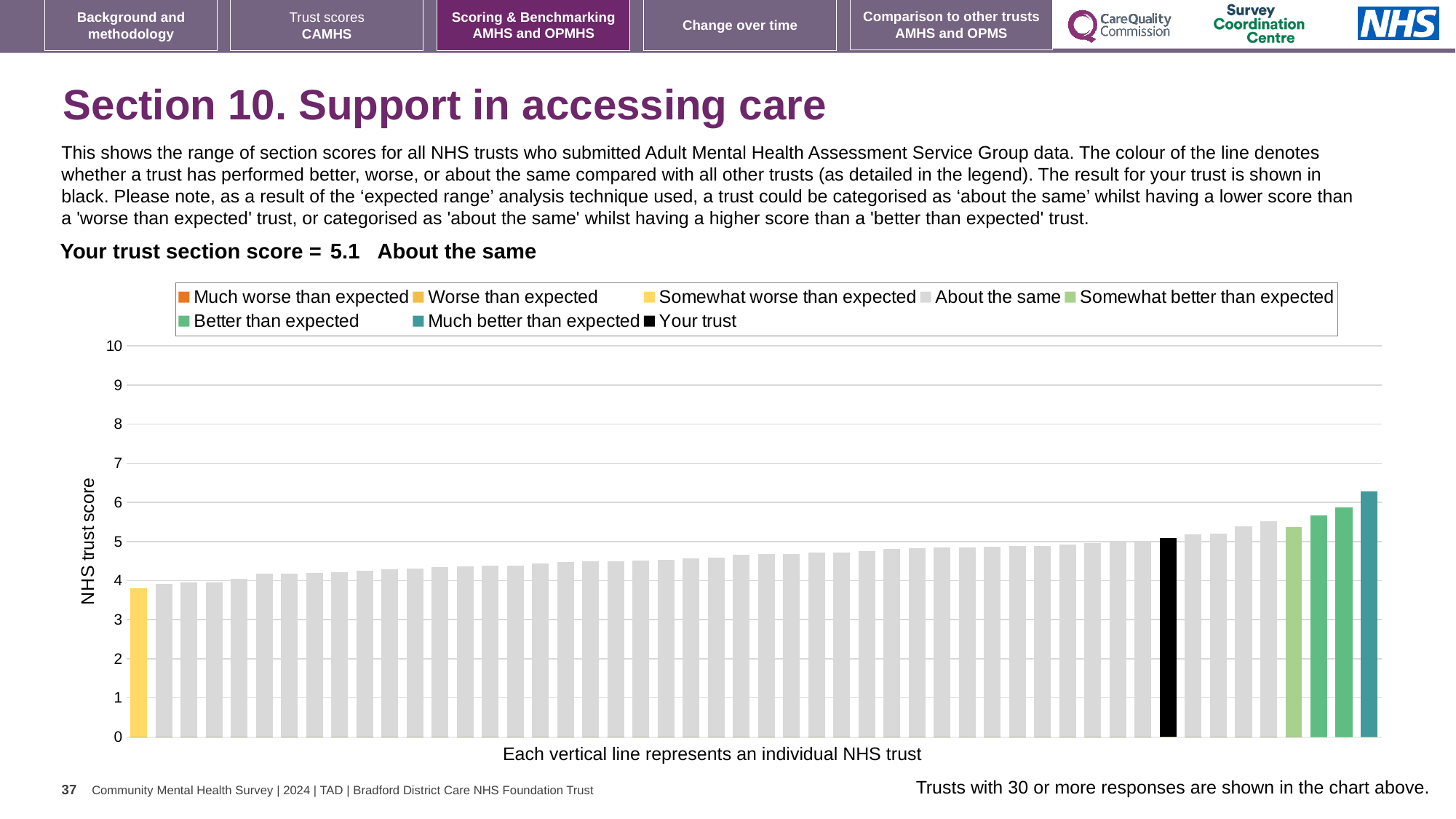
Do the bar values rise or fall from left to right along the x axis? rise Is the value of the lowest bar greater or less than 4? less What colour is the bar representing your trust? black What kind of chart is shown on the slide? bar chart Which legend category does the highest bar belong to? Much better than expected Is the value of the highest bar greater or less than 7? less Is the value for your trust greater or less than 5? greater Which is larger, the leftmost bar or the rightmost bar? the rightmost bar What is the label on the y axis of the chart? NHS trust score How many entries does the chart legend list? 8 What is the section score for your trust? 5.1